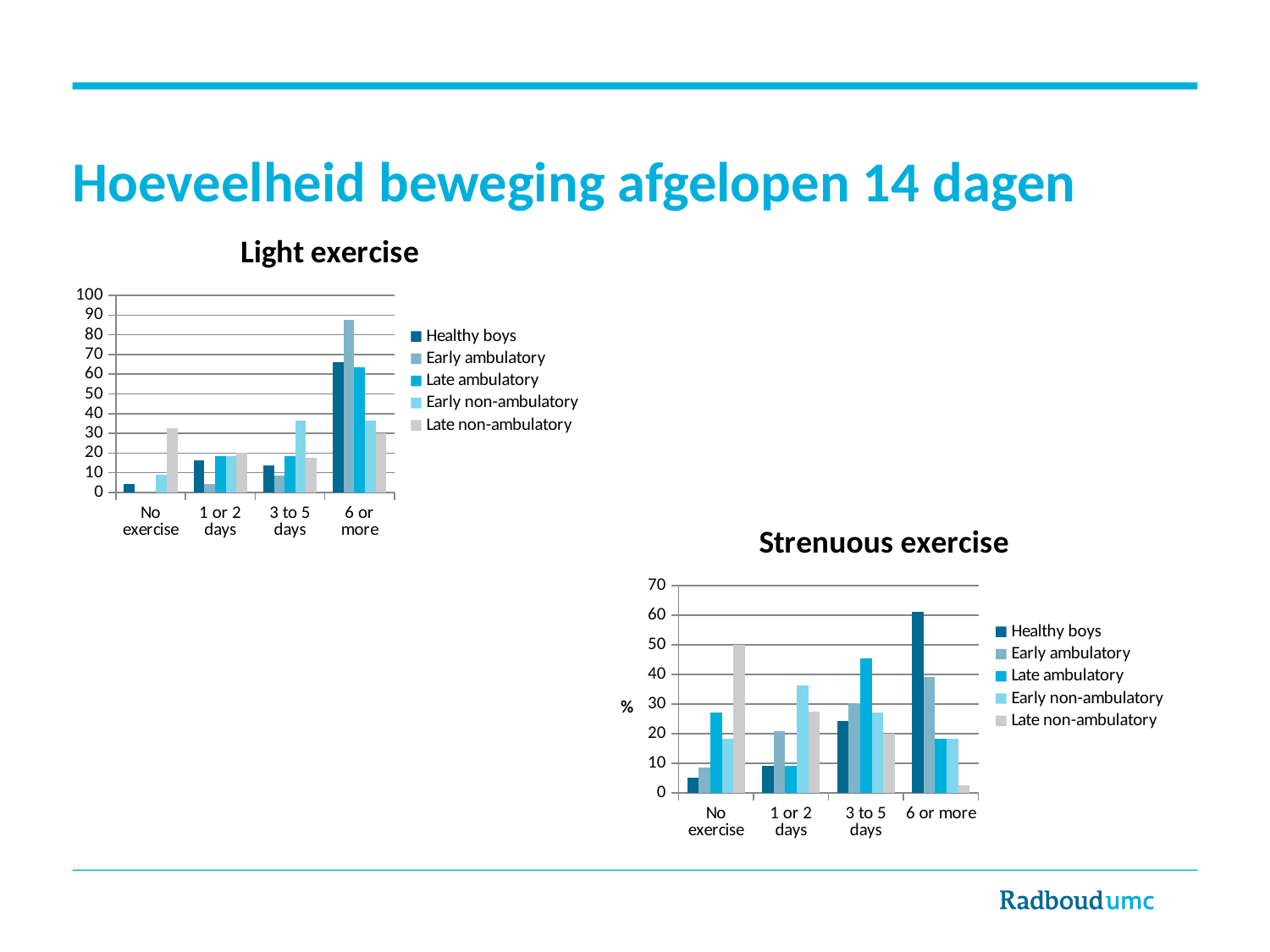
In the "Strenuous exercise" chart, which series has the lowest value for "6 or more"? Late non-ambulatory How many series does the legend of the "Light exercise" chart list? 5 In the "Strenuous exercise" chart, is the value for Healthy boys at "6 or more" greater or less than 50? greater How many categories are shown on the x axis of the "Light exercise" chart? 4 In the "Light exercise" chart, which series has the highest value for "6 or more"? Early ambulatory In the "Strenuous exercise" chart, which series has the highest value for "6 or more"? Healthy boys In the "Strenuous exercise" chart, for "3 to 5 days", which is larger: Late ambulatory or Healthy boys? Late ambulatory In the "Strenuous exercise" chart, is the value for Late non-ambulatory at "No exercise" greater or less than 40? greater In the "Light exercise" chart, is the value for Early ambulatory at "6 or more" greater or less than 80? greater What kind of chart is the "Light exercise" chart? bar chart What is the label on the vertical axis of the "Strenuous exercise" chart? %